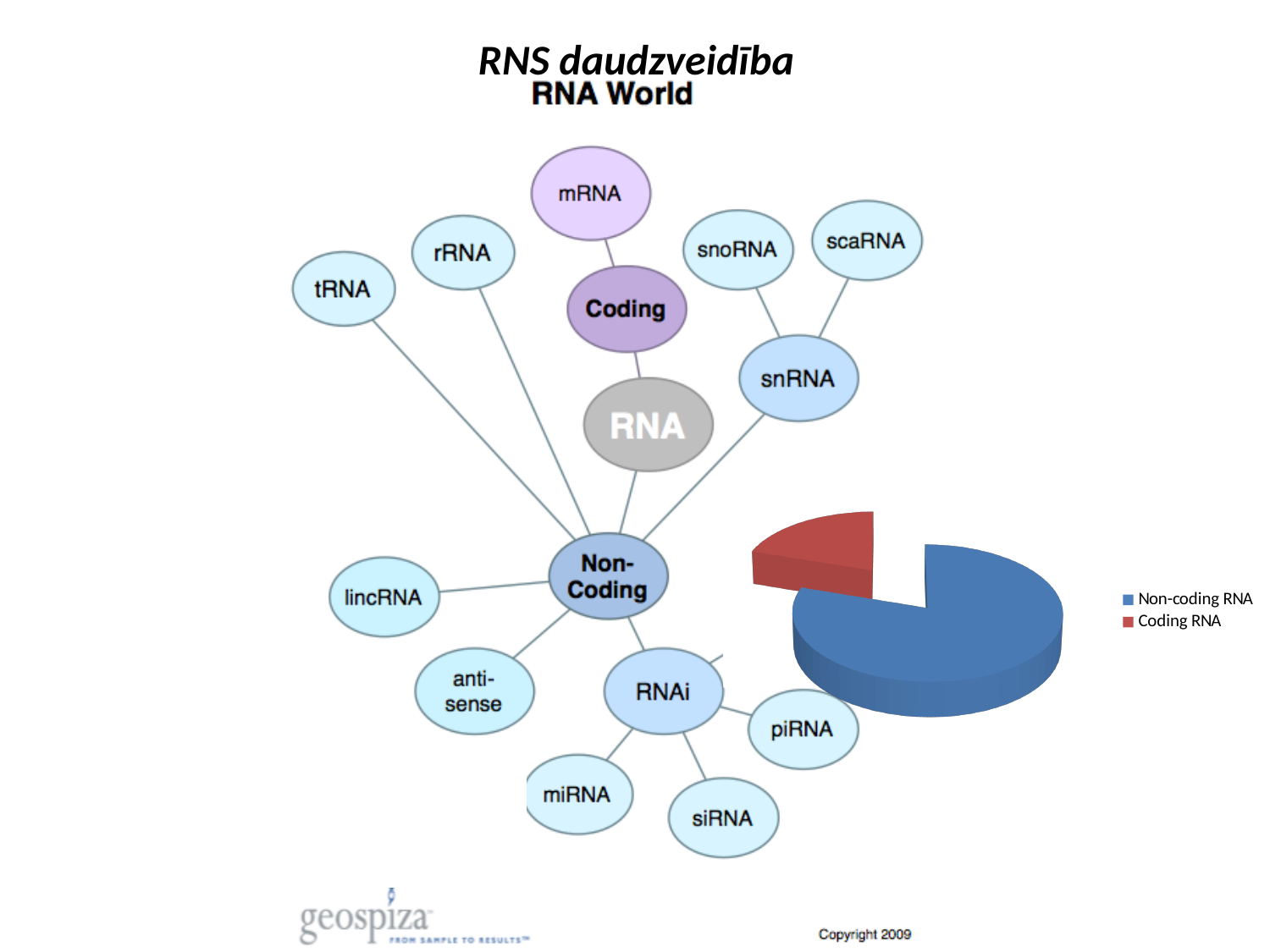
What colour is the Coding RNA slice in the pie chart? red Which slice of the pie chart is pulled out (exploded) from the rest of the pie? Coding RNA How many slices does the pie chart have? 2 How many entries does the legend of the pie chart list? 2 Which slice of the pie chart is the smallest? Coding RNA In the pie chart, which is larger: Non-coding RNA or Coding RNA? Non-coding RNA What kind of chart is shown on the right side of the slide? pie chart Which slice of the pie chart is the largest? Non-coding RNA